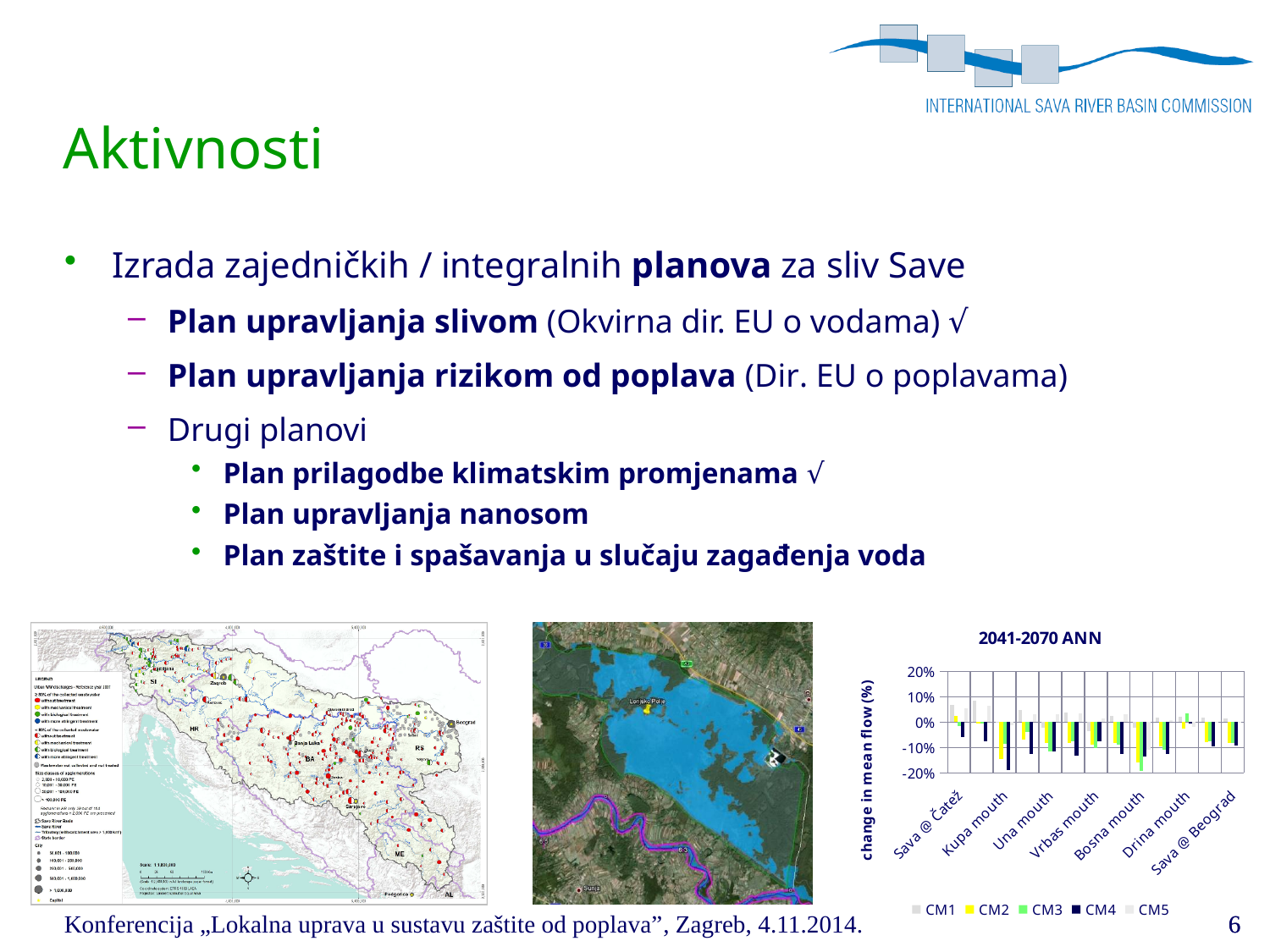
In the 2041-2070 ANN chart, is the CM4 value for Kupa mouth greater or less than -20%? greater In the 2041-2070 ANN chart, which is the first category on the x axis? Sava @ Čatež What is the title of the chart on the slide? 2041-2070 ANN In the 2041-2070 ANN chart, is the CM1 value for Sava @ Čatež greater or less than 0%? greater In the 2041-2070 ANN chart, is the CM4 value for Una mouth greater or less than -10%? less What type of chart is shown under the title 2041-2070 ANN? bar chart How many series does the legend of the 2041-2070 ANN chart list? 5 What is the label of the y axis of the 2041-2070 ANN chart? change in mean flow (%)